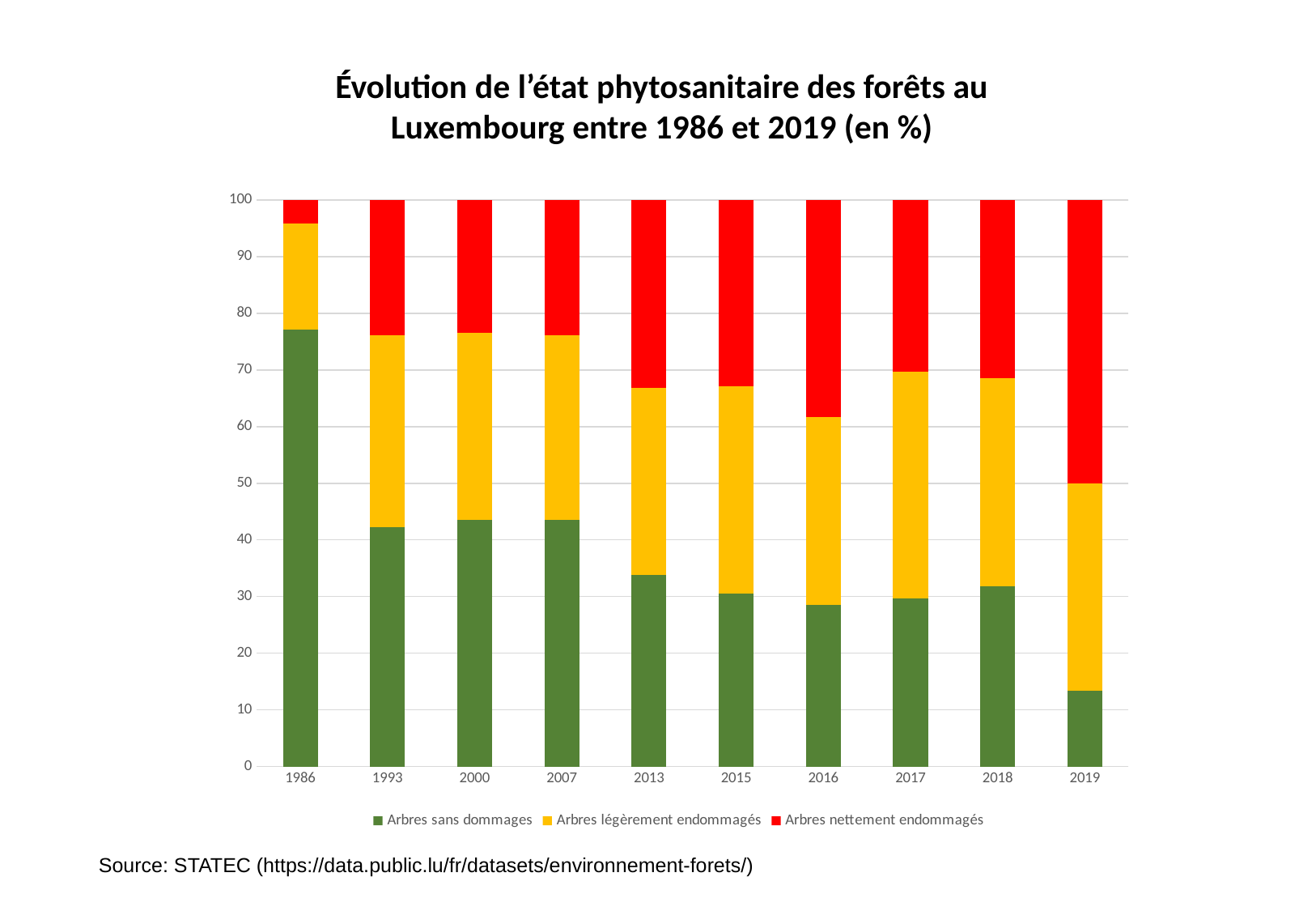
What colour represents 'Arbres nettement endommagés' in the legend? red Is the value for 'Arbres sans dommages' in 2013 greater or less than 30? greater Which year has a larger share of 'Arbres sans dommages', 1986 or 2019? 1986 How many series does the legend list? 3 Is the value for 'Arbres sans dommages' in 1986 greater or less than 70? greater Does the share of 'Arbres sans dommages' rise or fall overall from 1986 to 2019? fall In which year is the share of 'Arbres nettement endommagés' the largest? 2019 How many years are shown on the x axis of the chart? 10 Is the value for 'Arbres sans dommages' in 2019 greater or less than 20? less In which year is the share of 'Arbres sans dommages' the lowest? 2019 What kind of chart is shown on the slide? stacked bar chart In which year is the share of 'Arbres sans dommages' the highest? 1986